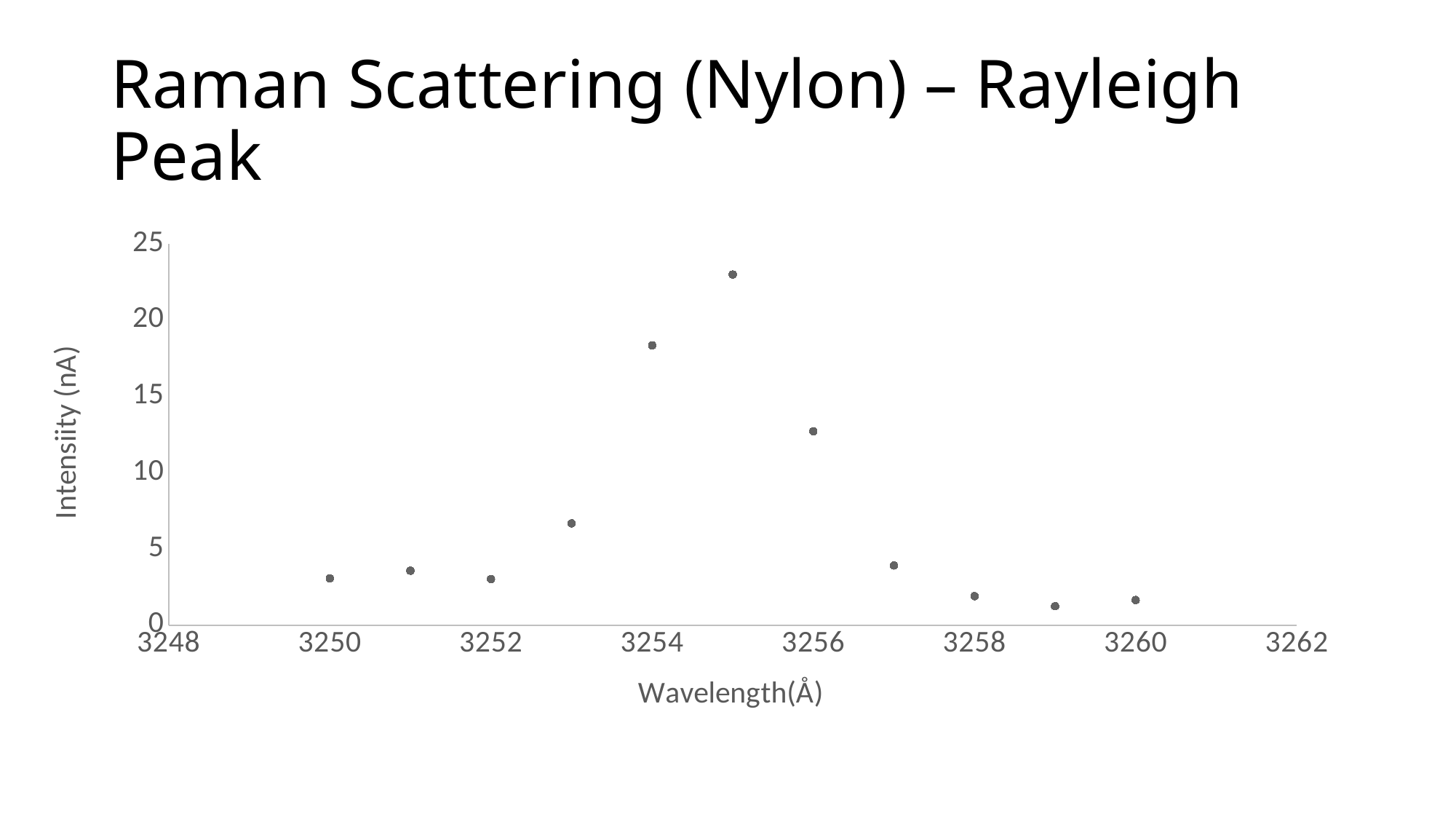
Which has the higher intensity, wavelength 3254 or wavelength 3256? 3254 Is the intensity at wavelength 3254 greater or less than 15? greater At which wavelength is the intensity highest? 3255 What is the label of the y axis? Intensiity (nA) What kind of chart is shown on the slide? scatter chart What is the label of the x axis? Wavelength(Å) Is the intensity at wavelength 3258 greater or less than 5? less Is the intensity at wavelength 3255 greater or less than 20? greater Do the intensity values rise or fall as the wavelength goes from 3255 to 3259? fall How many data points are plotted on the chart? 11 Which has the higher intensity, wavelength 3253 or wavelength 3257? 3253